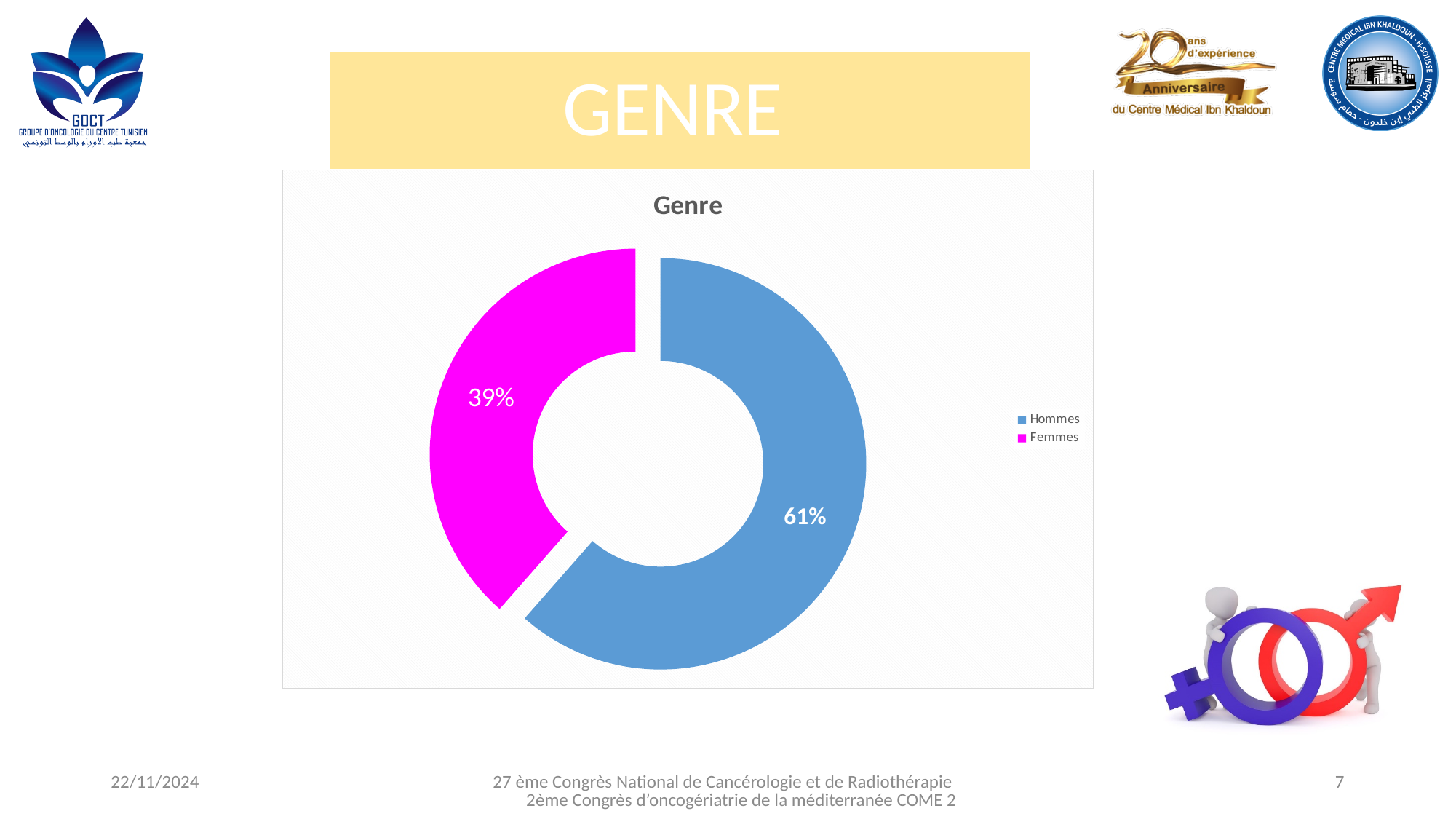
What percentage of the chart is Hommes? 61% What kind of chart is shown on the slide? Doughnut chart Which category has the largest share of the chart? Hommes What is the total of the two percentages shown on the chart? 100% What percentage of the chart is Femmes? 39% What is the difference in percentage points between Hommes and Femmes? 22 How many categories does the chart show? 2 Which category has the smallest share of the chart? Femmes What is the title of the chart? Genre Which is larger, the share for Hommes or the share for Femmes? Hommes What colour represents Femmes in the chart? Magenta